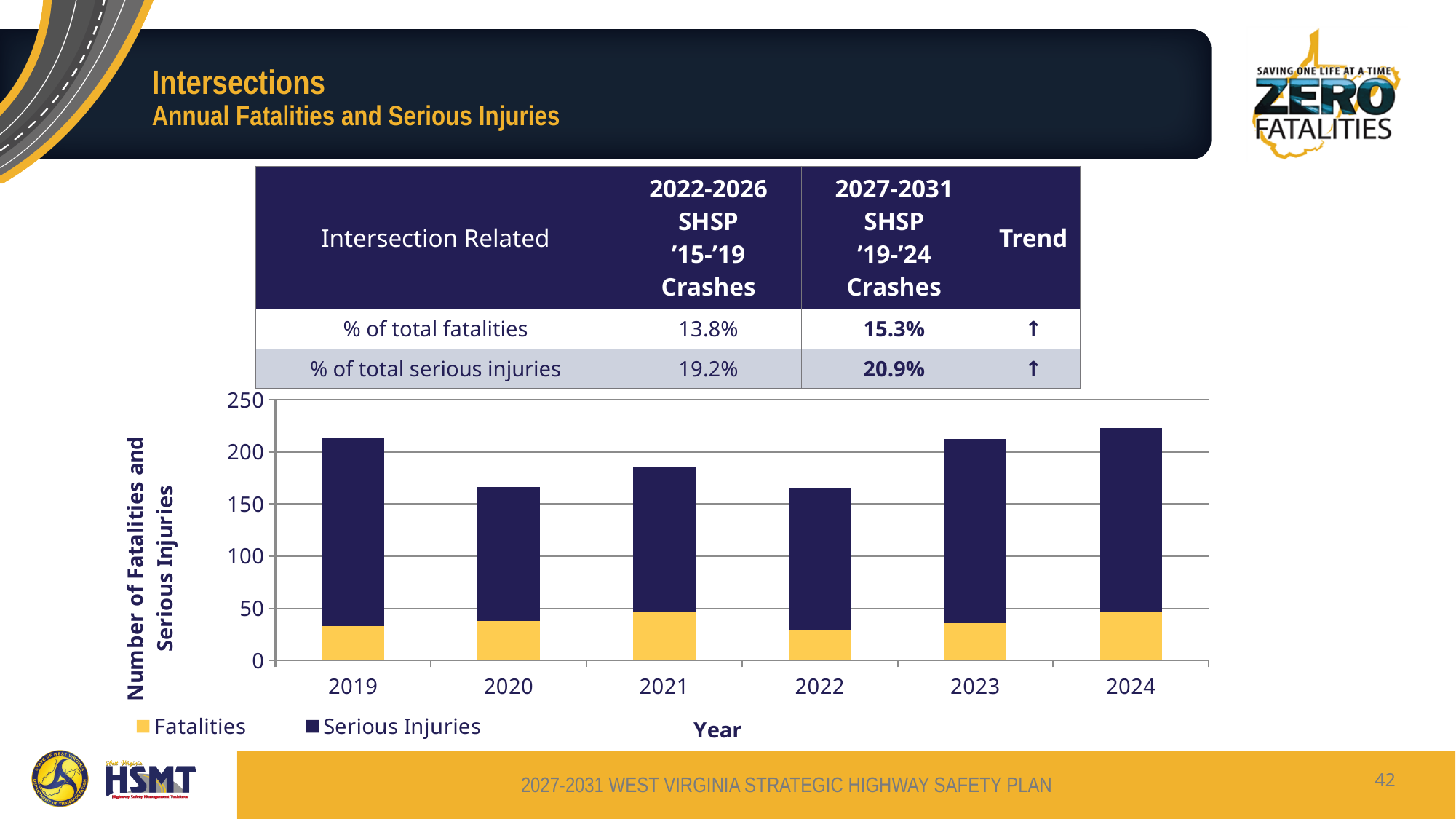
How many years are shown on the x axis of the chart? 6 Which year has the tallest stacked bar in the chart? 2024 Is the total stacked bar for 2022 greater or less than 200? less How many series does the chart legend list? 2 Is the Fatalities value for 2022 greater or less than 50? less What kind of chart is shown on the slide? Bar chart What are the two series named in the chart legend? Fatalities and Serious Injuries Is the total stacked bar for 2019 greater or less than 200? greater Which year has the taller stacked bar, 2023 or 2020? 2023 Which year has the taller stacked bar, 2021 or 2022? 2021 What is the title of the chart's y axis? Number of Fatalities and Serious Injuries